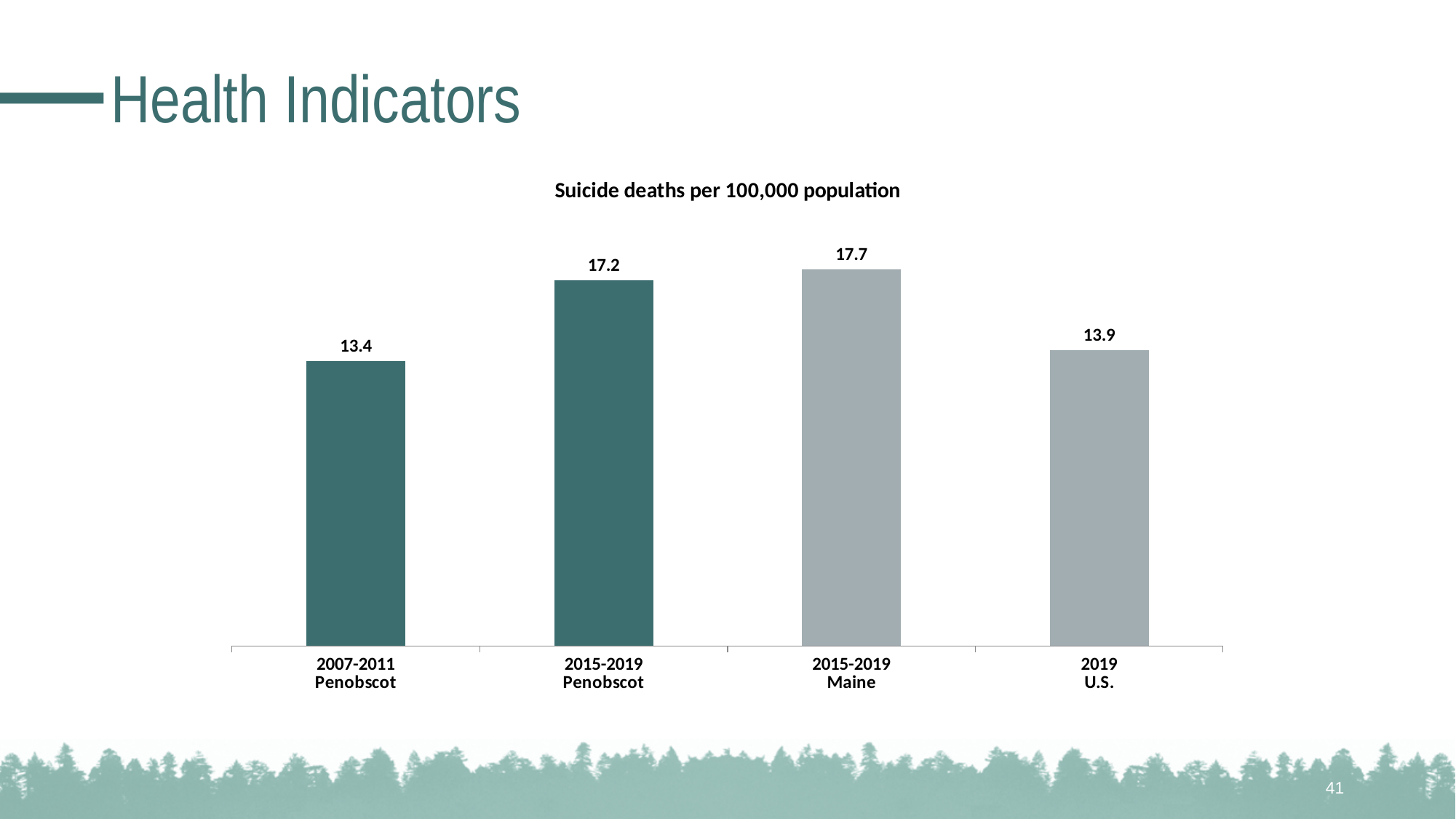
What is the title of the chart? Suicide deaths per 100,000 population Which is larger, the value for 2015-2019 Penobscot or the value for 2019 U.S.? 2015-2019 Penobscot Which category has the highest value? 2015-2019 Maine What is the value for 2015-2019 Penobscot? 17.2 What is the value for 2015-2019 Maine? 17.7 Which category has the lowest value? 2007-2011 Penobscot What is the difference between the 2015-2019 Maine value and the 2019 U.S. value? 3.8 What is the difference between the 2015-2019 Penobscot value and the 2007-2011 Penobscot value? 3.8 How many categories are shown in the chart? 4 What kind of chart is shown on the slide? Bar chart What is the value for 2007-2011 Penobscot? 13.4 What is the value for 2019 U.S.? 13.9